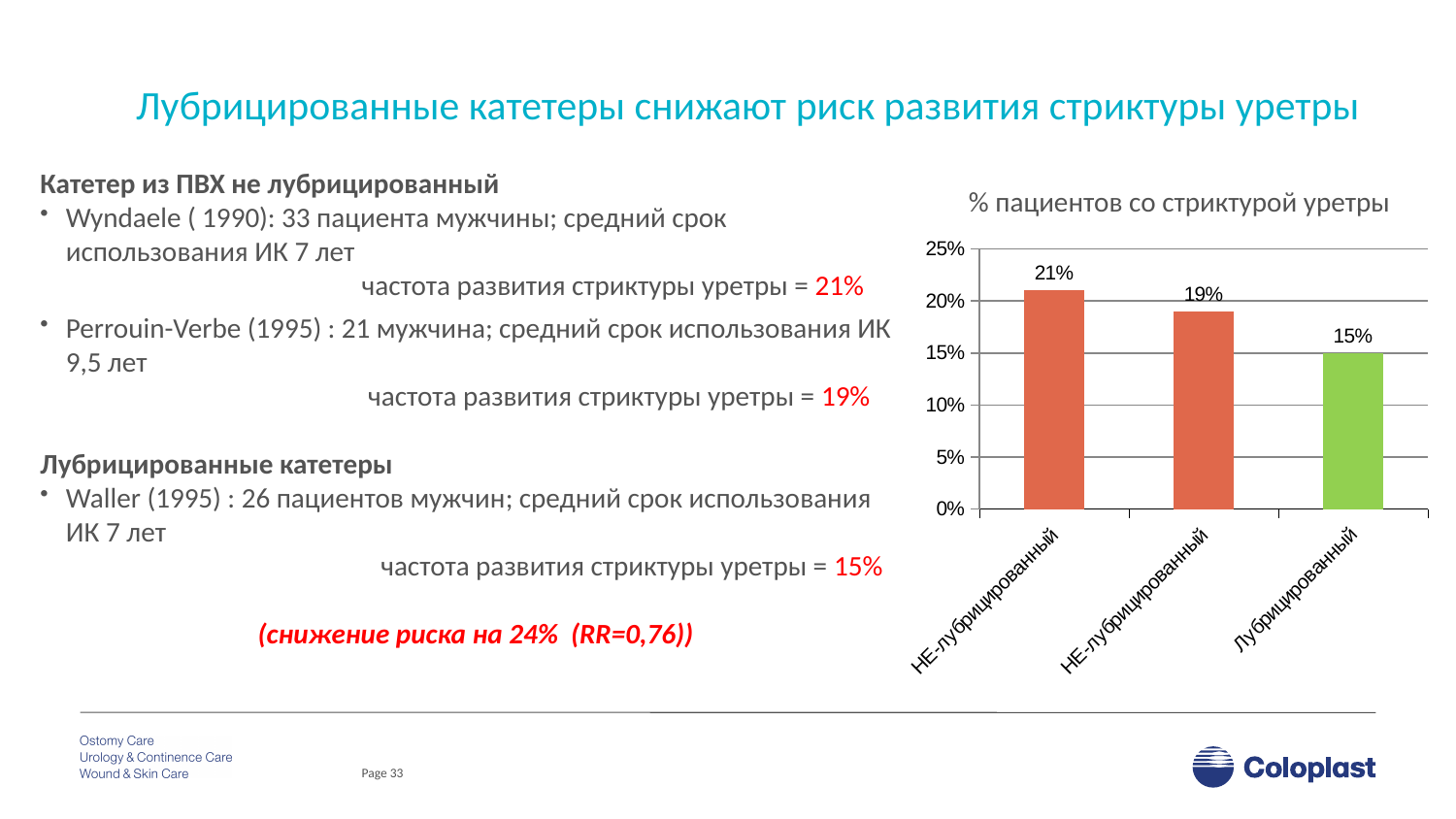
Which bar has the lowest value? Лубрицированный What is the value of the first (leftmost) bar, labelled НЕ-лубрицированный? 21% What is the value of the second (middle) bar, labelled НЕ-лубрицированный? 19% How many bars are plotted in the chart? 3 Which bar has the highest value? the first НЕ-лубрицированный bar (21%) Do the bar values rise or fall from left to right across the chart? fall What is the difference between the two НЕ-лубрицированный bars? 2% What is the difference between the first НЕ-лубрицированный bar and the Лубрицированный bar? 6% What type of chart is shown on the slide? bar chart What is the title of the chart? % пациентов со стриктурой уретры Which is larger, the second НЕ-лубрицированный bar or the Лубрицированный bar? the second НЕ-лубрицированный bar What is the value of the bar labelled Лубрицированный? 15%